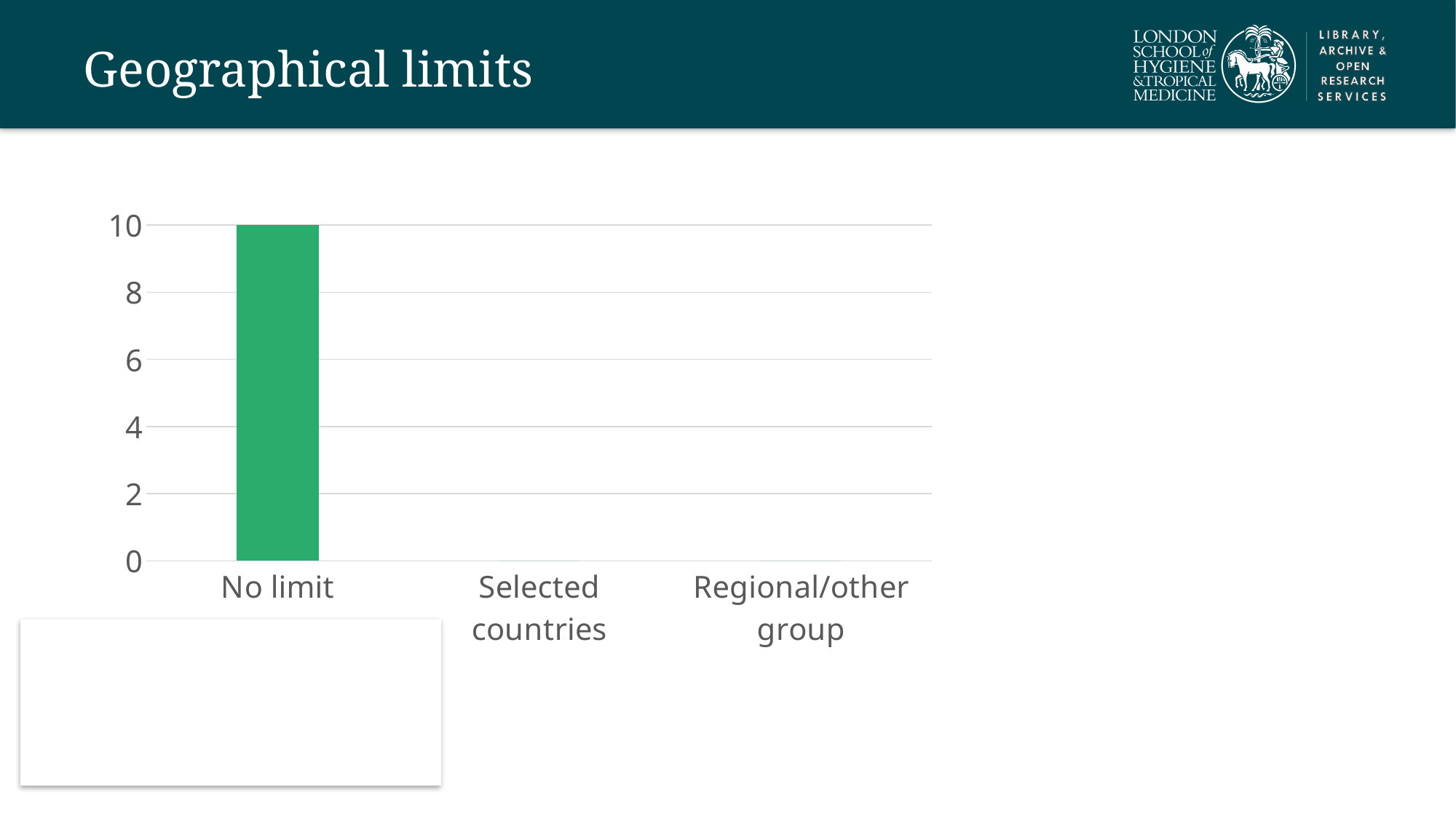
What is the value for No limit? 10 How many categories are shown on the x axis? 3 Is the value for No limit greater or less than 8? greater Which category has the highest value? No limit Which is larger, the value for No limit or the value for Regional/other group? No limit Is the value for Selected countries greater or less than 2? less What colour is the bar for No limit? Green What kind of chart is shown on the slide? Bar chart Which is larger, the value for No limit or the value for Selected countries? No limit What is the highest value shown on the y axis? 10 Is the value for Regional/other group greater or less than 2? less What is the title of the slide containing the chart? Geographical limits